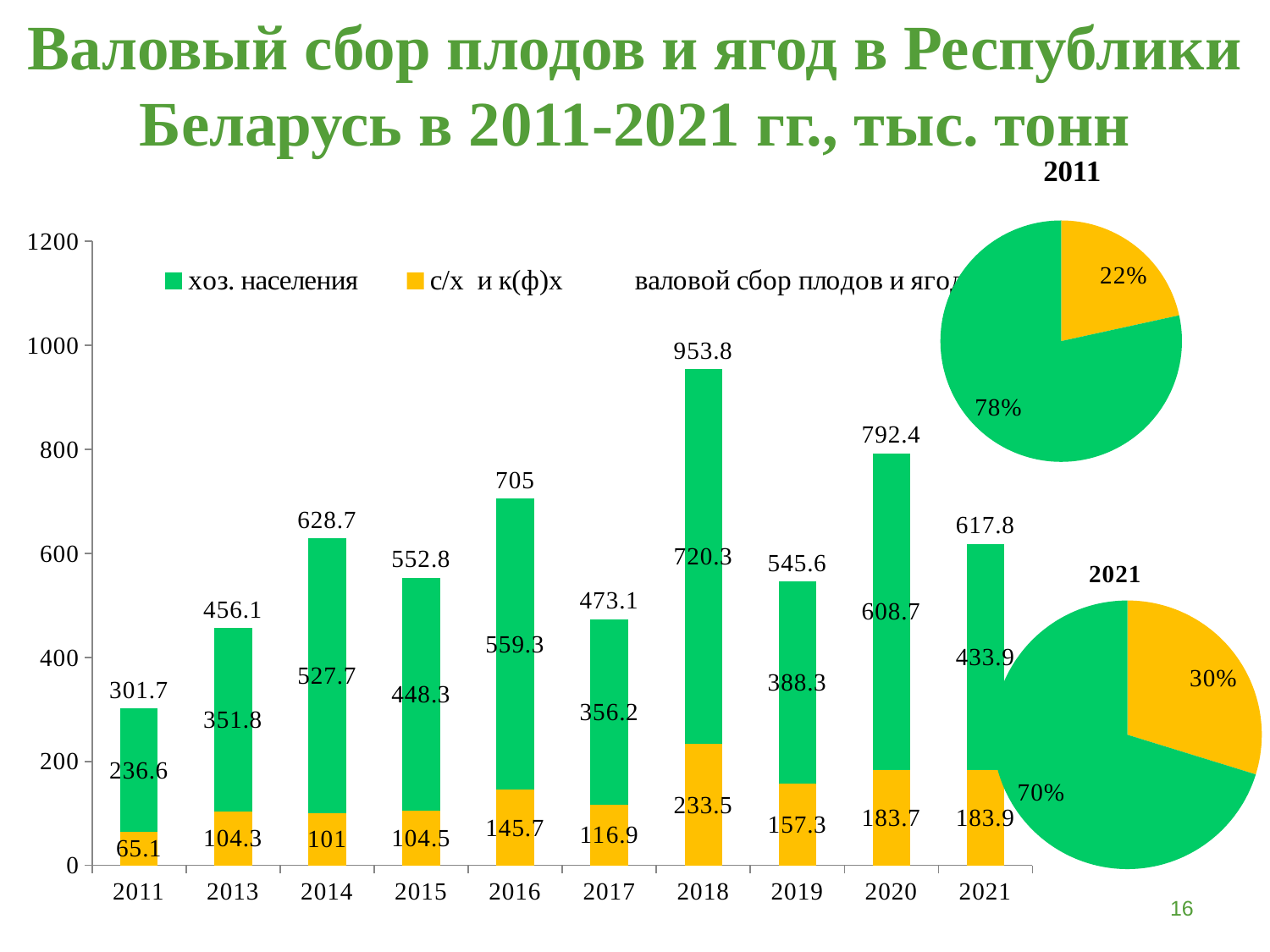
In the bar chart, what is the difference between the хоз. населения values for 2018 and 2019? 332 In the bar chart, what is the value for хоз. населения in 2016? 559.3 In the bar chart, which is larger: the хоз. населения value in 2014 or in 2015? 2014 How many series does the legend of the bar chart list? 3 In the bar chart, what is the total gross harvest shown above the bar for 2020? 792.4 In the bar chart, which year has the highest total gross harvest? 2018 How many years are shown on the x axis of the bar chart? 10 In the bar chart, which year has the lowest value for с/х и к(ф)х? 2011 In the bar chart, what is the value for с/х и к(ф)х in 2018? 233.5 In the bar chart, is the total for 2017 greater or less than 400? greater In the 2021 pie chart, what share does the yellow slice (с/х и к(ф)х) have? 30% What kind of chart is the large chart on the left of the slide? Stacked bar chart